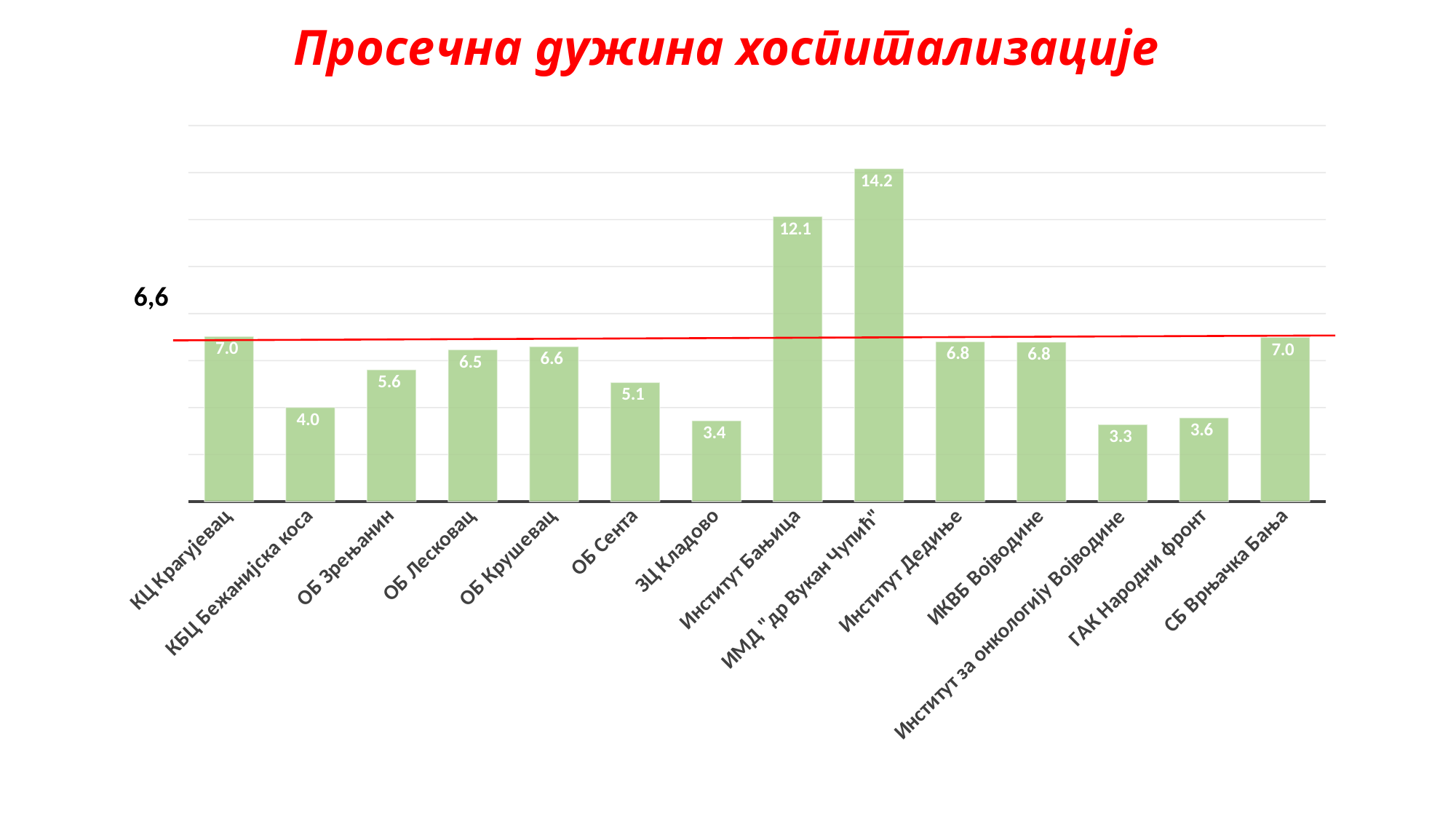
What is the average length of hospitalization shown for Институт Бањица? 12.1 What value is shown for ОБ Зрењанин? 5.6 Which institution has the highest average length of hospitalization? ИМД "др Вукан Чупић" What value is shown for ГАК Народни фронт? 3.6 What is the difference between the values for КЦ Крагујевац and КБЦ Бежанијска коса? 3.0 What is the difference between the values for ИМД "др Вукан Чупић" and Институт Бањица? 2.1 Which has a larger value, ОБ Сента or Институт Дедиње? Институт Дедиње Which institution has the lowest average length of hospitalization? Институт за онкологију Војводине How many institutions are shown on the chart? 14 What value is labelled on the red horizontal line across the chart? 6,6 What value is shown for ЗЦ Кладово? 3.4 What kind of chart is shown on the slide? Bar chart